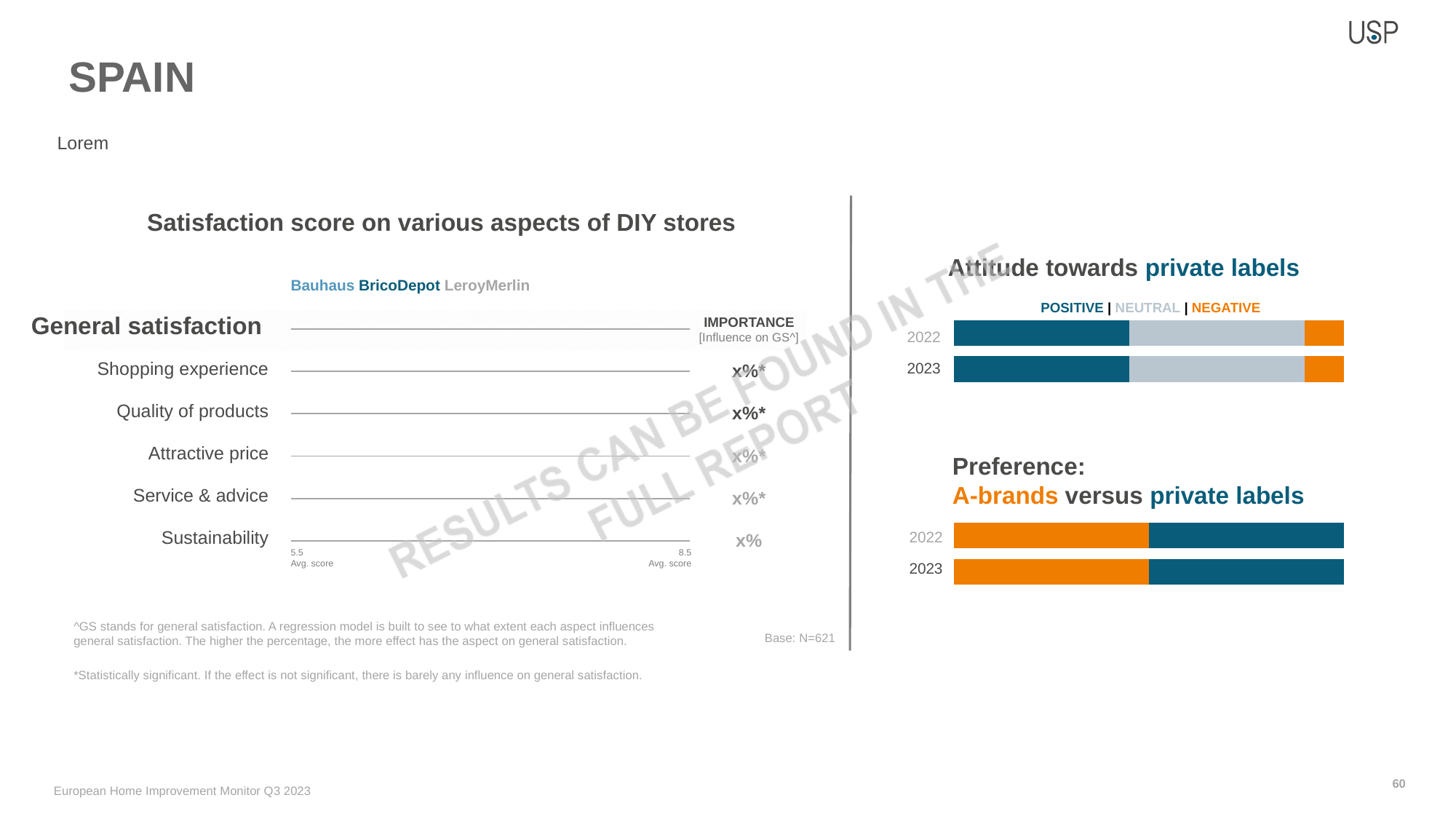
In the 'Satisfaction score on various aspects of DIY stores' chart, how many aspects are listed as rows, including General satisfaction? 6 In the 'Satisfaction score on various aspects of DIY stores' chart, which three store brands are listed in the legend? Bauhaus, BricoDepot, LeroyMerlin In the 'Preference: A-brands versus private labels' chart, how many series are shown in each bar? 2 What kind of chart is the 'Attitude towards private labels' chart? Stacked bar chart In the 'Attitude towards private labels' chart, which segment is the smallest in the 2022 bar? NEGATIVE In the 'Attitude towards private labels' chart, how many years are shown as bars? 2 What kind of chart is the 'Preference: A-brands versus private labels' chart? Stacked bar chart In the 'Attitude towards private labels' chart, how many series does the legend list? 3 In the 'Preference: A-brands versus private labels' chart, how many years are shown? 2 In the 'Satisfaction score on various aspects of DIY stores' chart, how many store brands does the legend list? 3 In the 'Attitude towards private labels' chart, for 2023, which segment is larger: POSITIVE or NEGATIVE? POSITIVE In the 'Satisfaction score on various aspects of DIY stores' chart, what are the minimum and maximum values shown on the Avg. score axis? 5.5 and 8.5